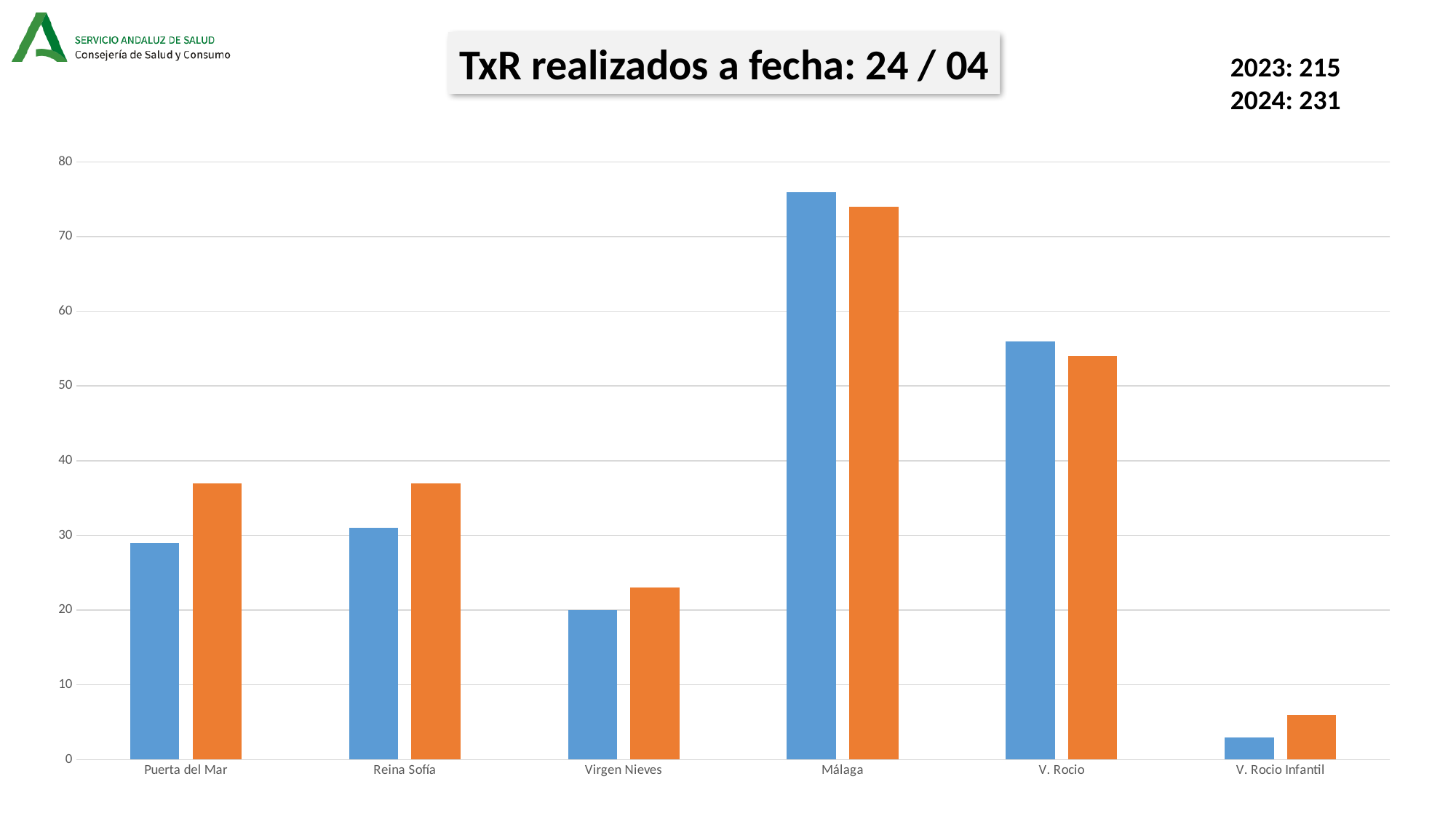
Which category has the tallest bars in the chart? Málaga Is the value of the blue bar for Virgen Nieves greater or less than 30? less Which category has the shortest bars in the chart? V. Rocio Infantil Is the value of the blue bar for Málaga greater or less than 70? greater What is the title shown above the chart? TxR realizados a fecha: 24 / 04 What kind of chart is shown on the slide? bar chart For Puerta del Mar, which bar is taller, the blue one or the orange one? the orange one Is the value of the orange bar for V. Rocio greater or less than 50? greater How many hospital categories are shown on the x axis of the chart? 6 For Reina Sofía, which bar is taller, the blue one or the orange one? the orange one